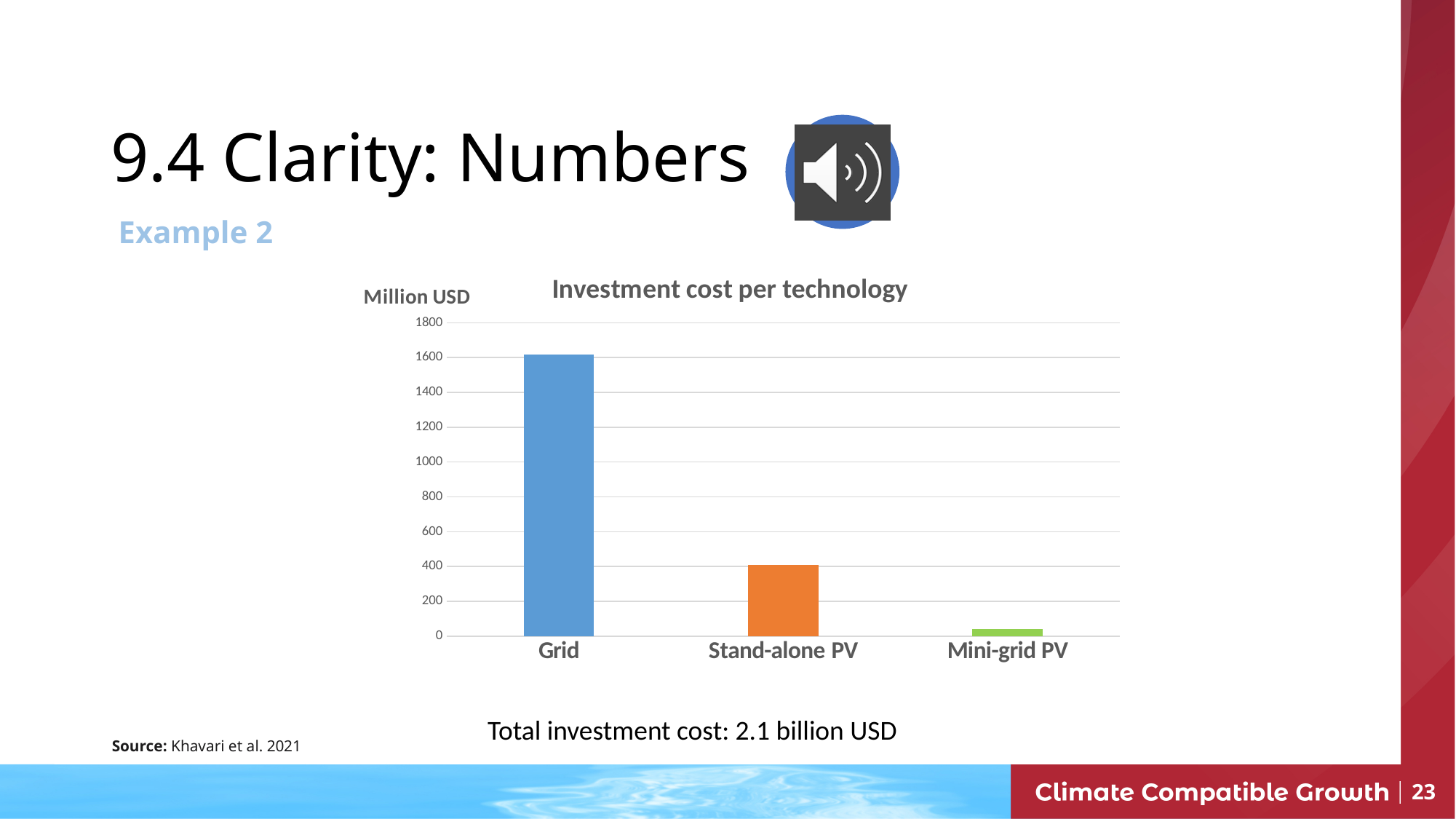
Which has a larger investment cost, Stand-alone PV or Mini-grid PV? Stand-alone PV Which technology has the highest investment cost? Grid Is the investment cost for Stand-alone PV greater or less than 600 million USD? less What type of chart is shown on the slide? bar chart Which has a larger investment cost, Grid or Stand-alone PV? Grid Do the investment costs rise or fall moving from Grid to Mini-grid PV along the x axis? fall Is the investment cost for Grid greater or less than 1400 million USD? greater Is the investment cost for Mini-grid PV greater or less than 200 million USD? less Which technology has the lowest investment cost? Mini-grid PV What is the title of the chart? Investment cost per technology What unit is shown on the vertical axis of the chart? Million USD How many technology categories are shown in the chart? 3